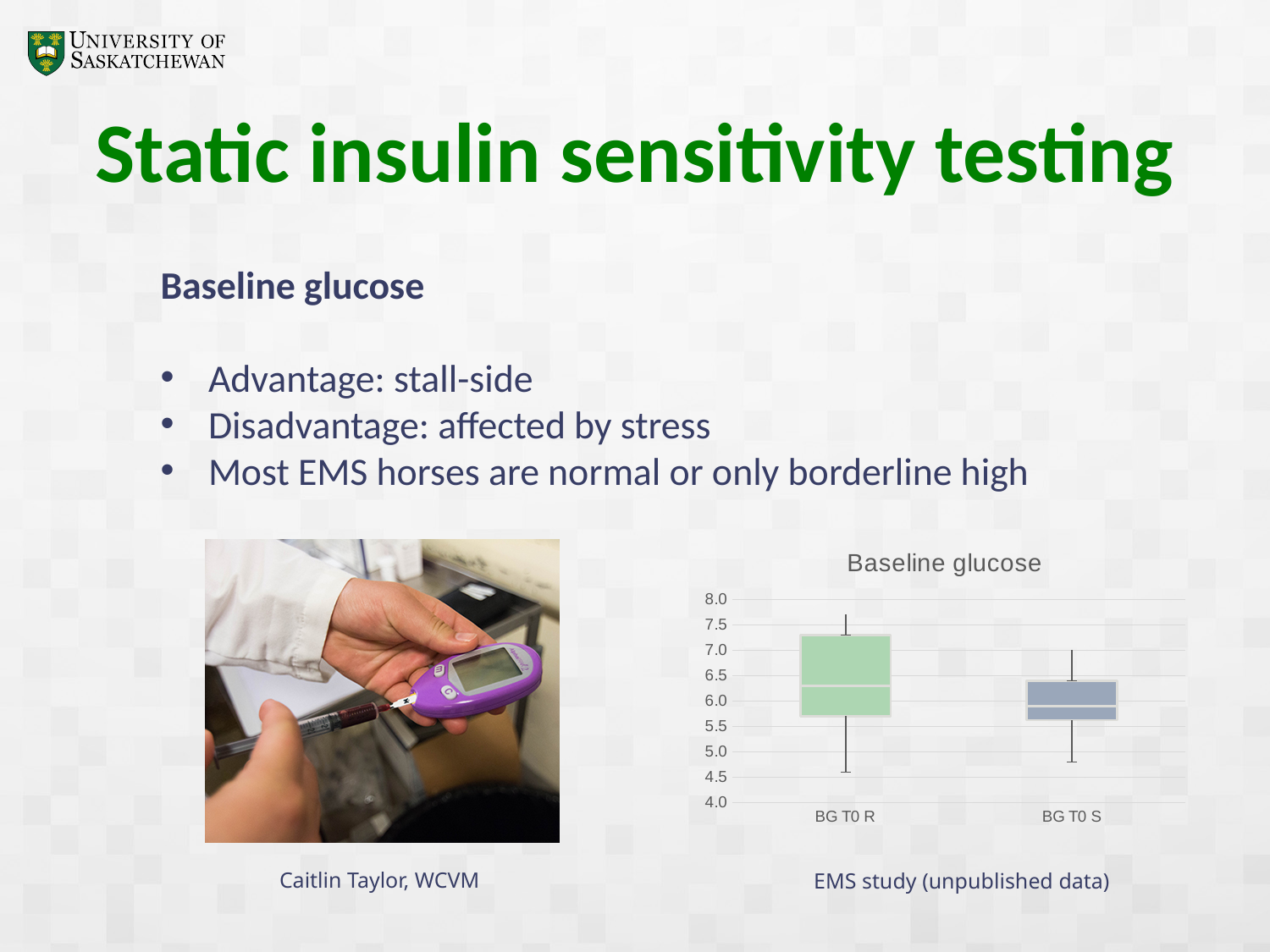
In the Baseline glucose chart, is the median for BG T0 R greater or less than 6.0? greater In the Baseline glucose chart, is the bottom of the lower whisker for BG T0 S greater or less than 5.0? less In the Baseline glucose chart, is the top of the upper whisker for BG T0 R greater or less than 7.0? greater What are the two category labels on the x axis of the Baseline glucose chart? BG T0 R and BG T0 S How many categories are shown on the x axis of the Baseline glucose chart? 2 What kind of chart is shown on the slide? Box plot What is the title of the chart on the slide? Baseline glucose In the Baseline glucose chart, which category has the higher median, BG T0 R or BG T0 S? BG T0 R In the Baseline glucose chart, which category has the larger box (interquartile range)? BG T0 R What is the highest value shown on the y axis of the Baseline glucose chart? 8.0